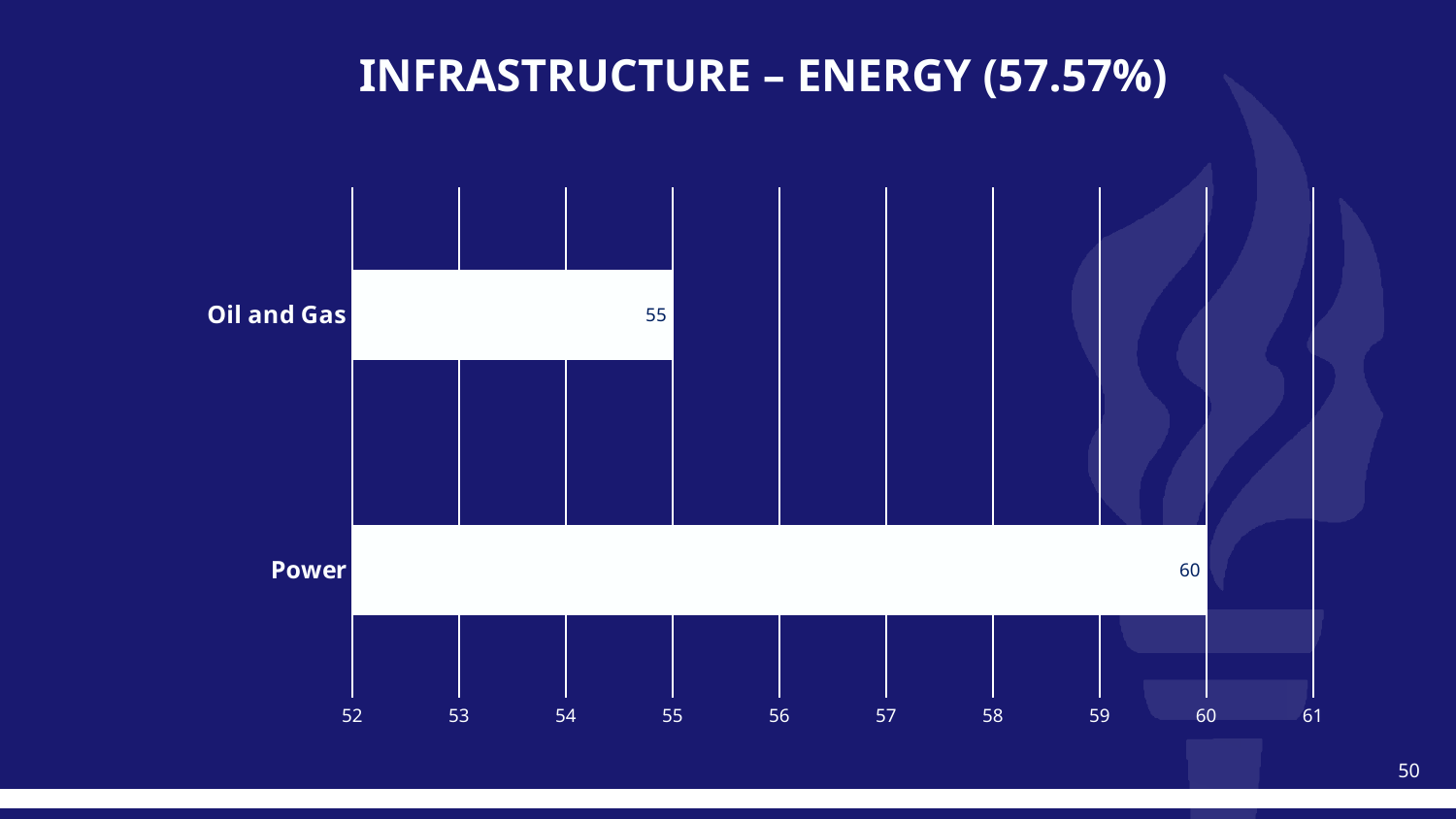
What kind of chart is shown on the slide? bar chart What is the value for Power? 60 Is the value for Power greater or less than 58? greater What is the difference between the values for Power and Oil and Gas? 5 What is the value for Oil and Gas? 55 Which category has the highest value? Power What is the title of the slide? INFRASTRUCTURE – ENERGY (57.57%) Which is larger, the value for Power or the value for Oil and Gas? Power How many categories are shown in the chart? 2 Is the value for Oil and Gas greater or less than 57? less Which category has the lowest value? Oil and Gas What is the highest value shown on the x axis? 61